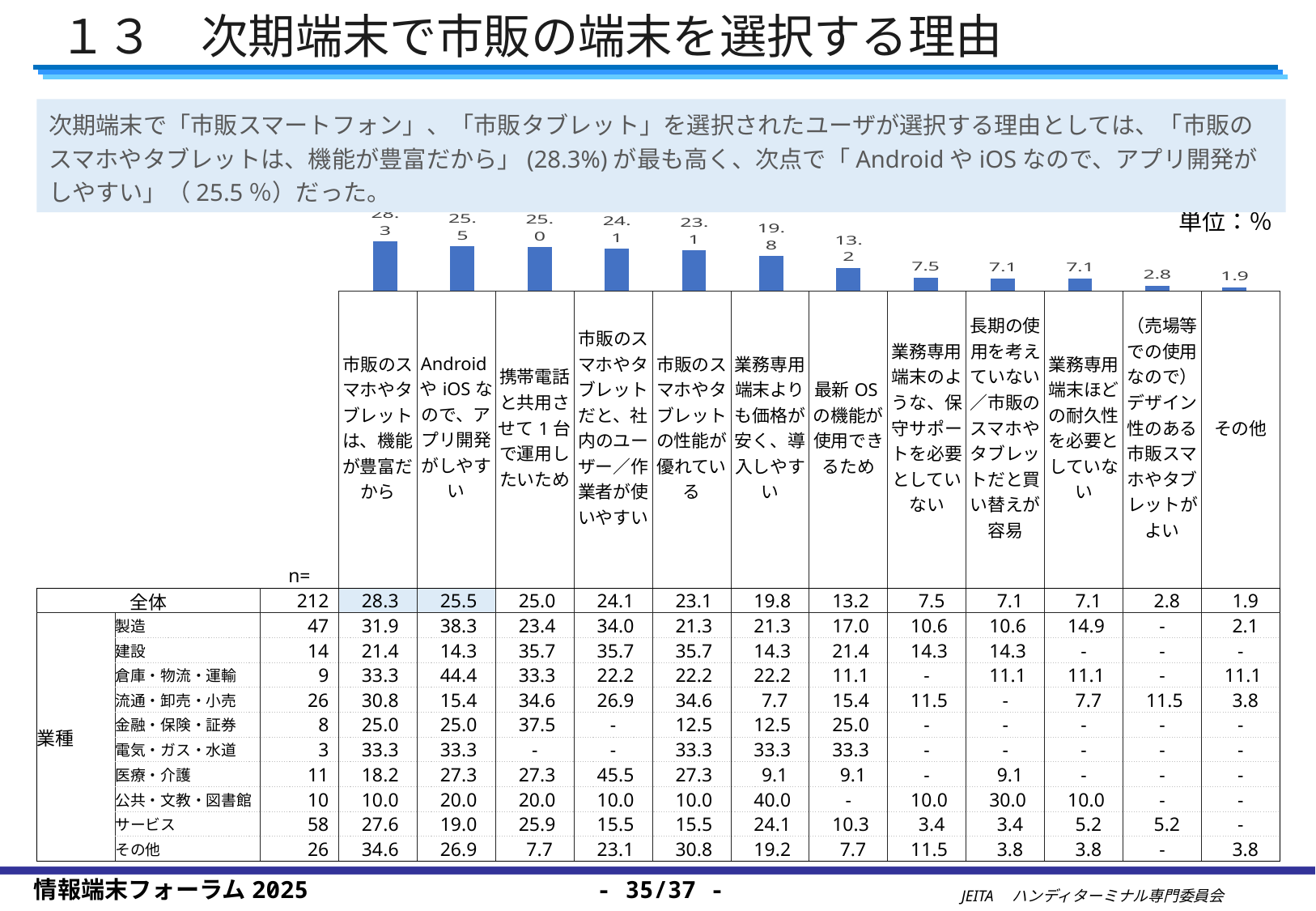
Which category has the lowest value in the chart? その他 Do the bar values rise or fall from left to right across the chart? fall What is the value for 「AndroidやiOSなので、アプリ開発がしやすい」? 25.5 Which is larger: the value for 「業務専用端末よりも価格が安く、導入しやすい」 or the value for 「最新OSの機能が使用できるため」? 業務専用端末よりも価格が安く、導入しやすい What is the difference between the values for 「市販のスマホやタブレットは、機能が豊富だから」 (28.3) and 「AndroidやiOSなので、アプリ開発がしやすい」 (25.5)? 2.8 What is the value for 「最新OSの機能が使用できるため」? 13.2 What is the value for 「市販のスマホやタブレットは、機能が豊富だから」? 28.3 What type of chart is shown on the slide? bar chart What unit is indicated for the chart values? % What is the value for 「その他」? 1.9 How many bars (categories) does the chart show? 12 Which category has the highest value in the chart? 市販のスマホやタブレットは、機能が豊富だから